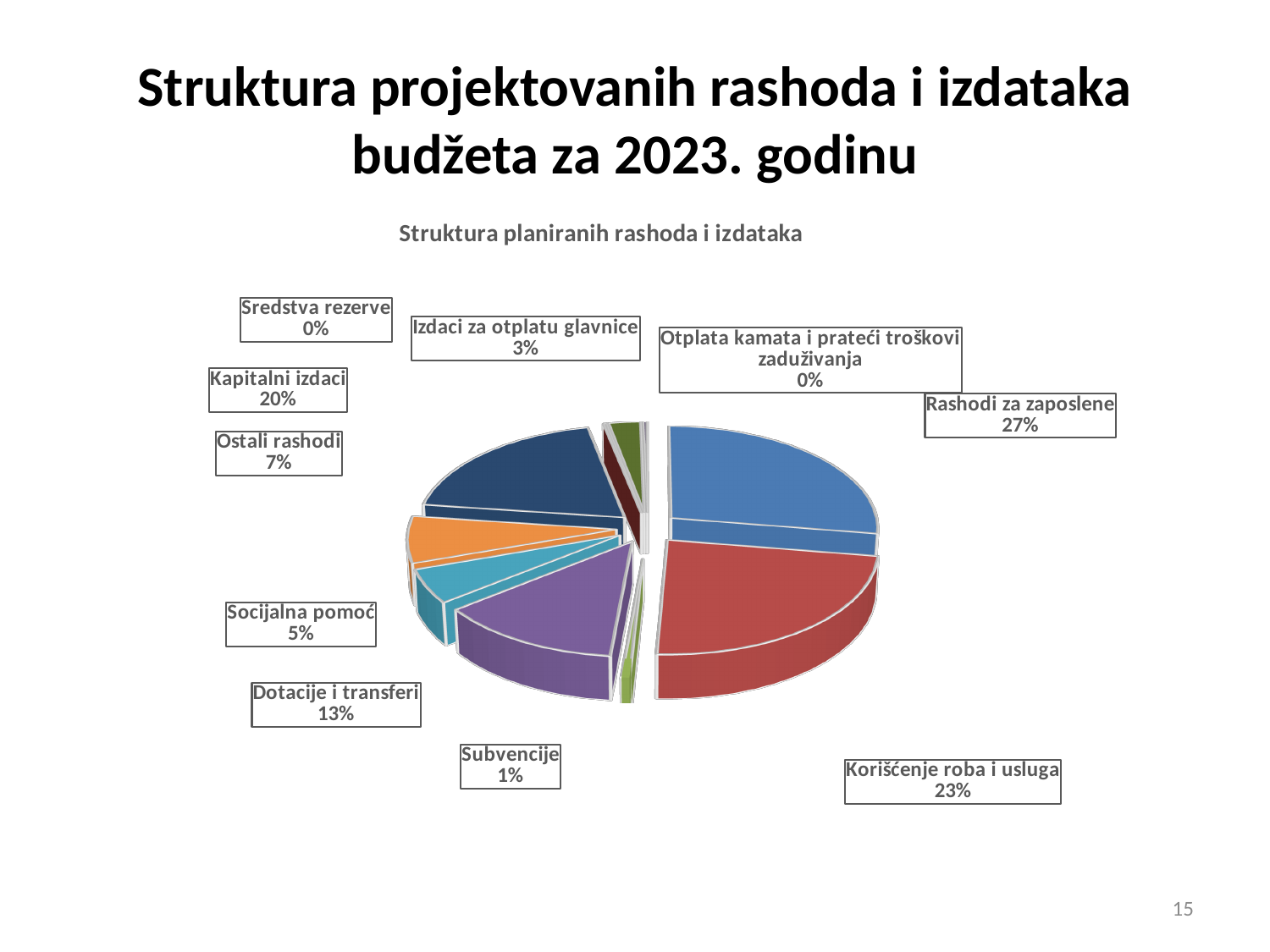
What share of the pie is Subvencije? 1% What share of the pie is Kapitalni izdaci? 20% What is the chart's title? Struktura planiranih rashoda i izdataka How many categories are labelled on the pie chart? 10 What share of the pie is Dotacije i transferi? 13% What share of the pie is Izdaci za otplatu glavnice? 3% Which is larger, Ostali rashodi or Socijalna pomoć? Ostali rashodi What kind of chart is shown on the slide? pie chart What share of the pie is Rashodi za zaposlene? 27% Which category has the largest share of the pie? Rashodi za zaposlene What is the difference between the shares of Rashodi za zaposlene and Korišćenje roba i usluga? 4% What share of the pie is Korišćenje roba i usluga? 23%